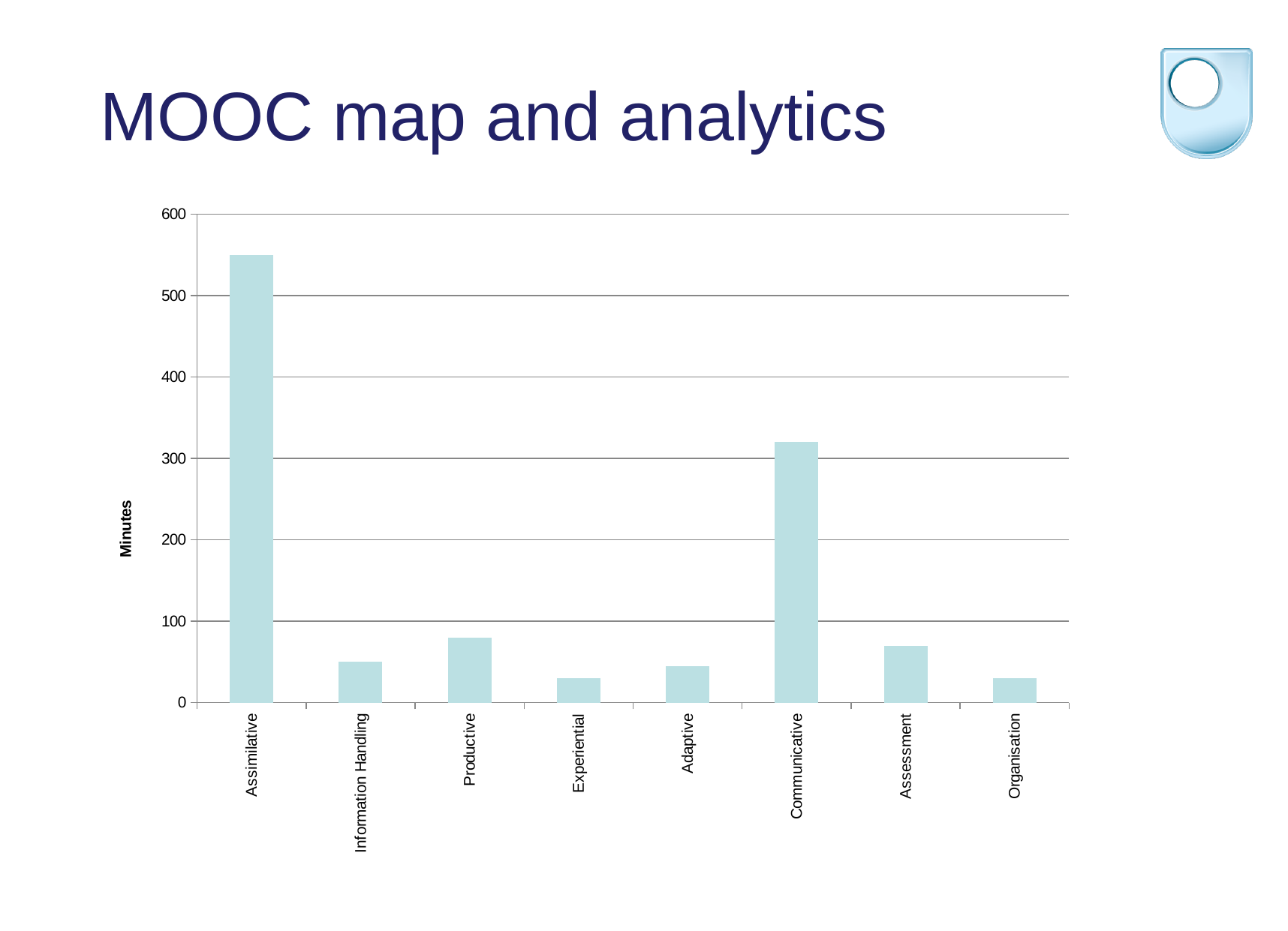
What is the label on the vertical axis of the chart? Minutes Which is larger, the value for Productive or the value for Experiential? Productive How many categories are shown on the x axis of the chart? 8 What kind of chart is shown on the slide? bar chart Is the value for Productive greater or less than 100? less Which is larger, the value for Communicative or the value for Assessment? Communicative Is the value for Information Handling greater or less than 100? less Which category has the highest value in the chart? Assimilative Is the value for Communicative greater or less than 300? greater What is the title of the slide containing the chart? MOOC map and analytics